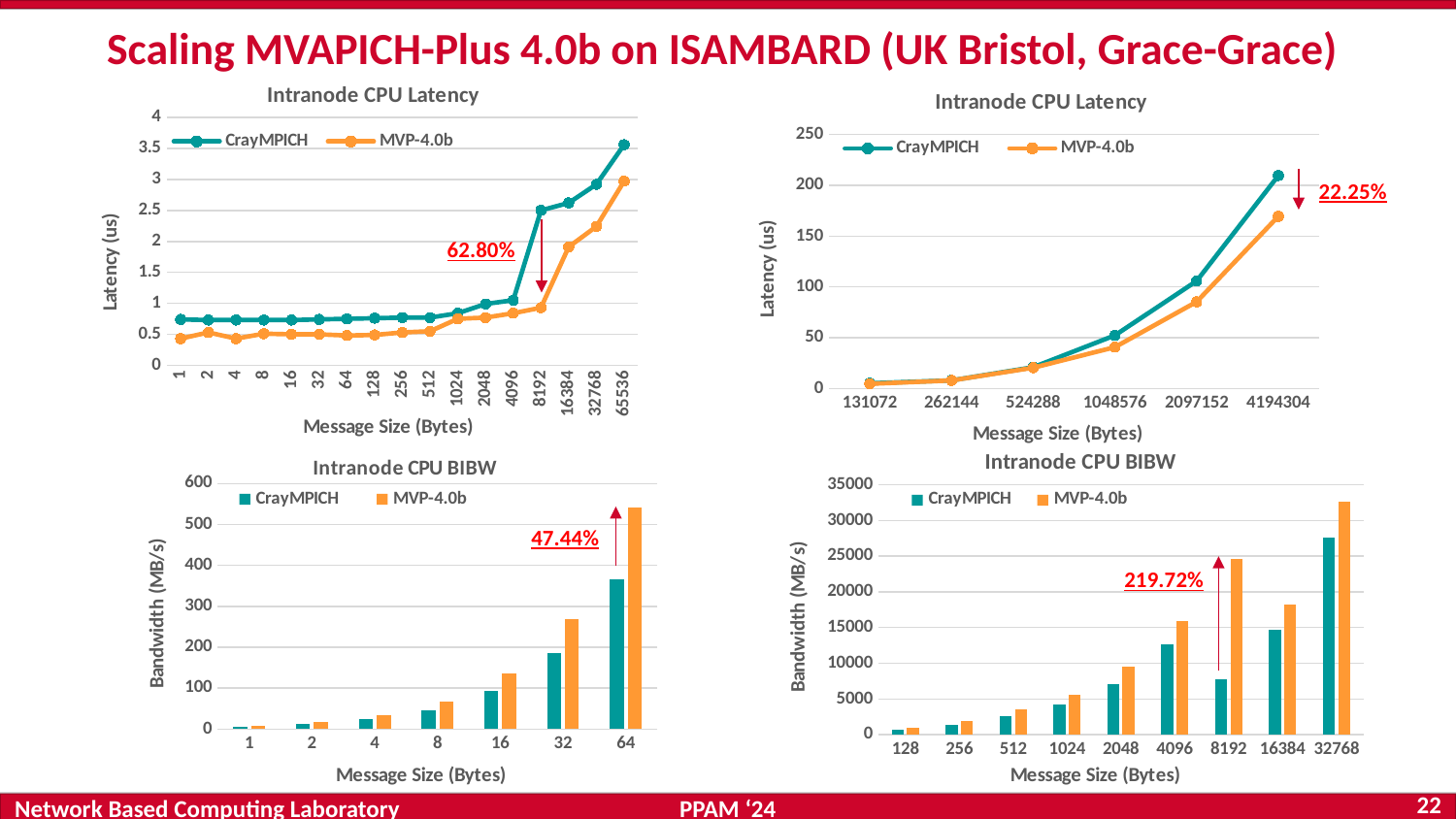
On the top-left Intranode CPU Latency chart, what percentage improvement is annotated at message size 8192? 62.80% On the bottom-right Intranode CPU BIBW chart, what percentage improvement is annotated at message size 8192? 219.72% On the bottom-left Intranode CPU BIBW chart, what kind of chart is shown? bar chart On the top-left Intranode CPU Latency chart, how many message sizes are plotted on the x axis? 17 On the top-left Intranode CPU Latency chart, what kind of chart is shown? line chart On the top-right Intranode CPU Latency chart, is the CrayMPICH value at message size 4194304 greater or less than 200? greater On the bottom-right Intranode CPU BIBW chart, which series has the larger bandwidth at message size 8192, CrayMPICH or MVP-4.0b? MVP-4.0b On the top-left Intranode CPU Latency chart, is the CrayMPICH value at message size 65536 greater or less than 3? greater On the top-left Intranode CPU Latency chart, how many series does the legend list? 2 On the top-right Intranode CPU Latency chart, how many message sizes are plotted on the x axis? 6 On the top-right Intranode CPU Latency chart, do the latency values rise or fall as message size increases? rise On the bottom-left Intranode CPU BIBW chart, is the MVP-4.0b value at message size 64 greater or less than 500? greater